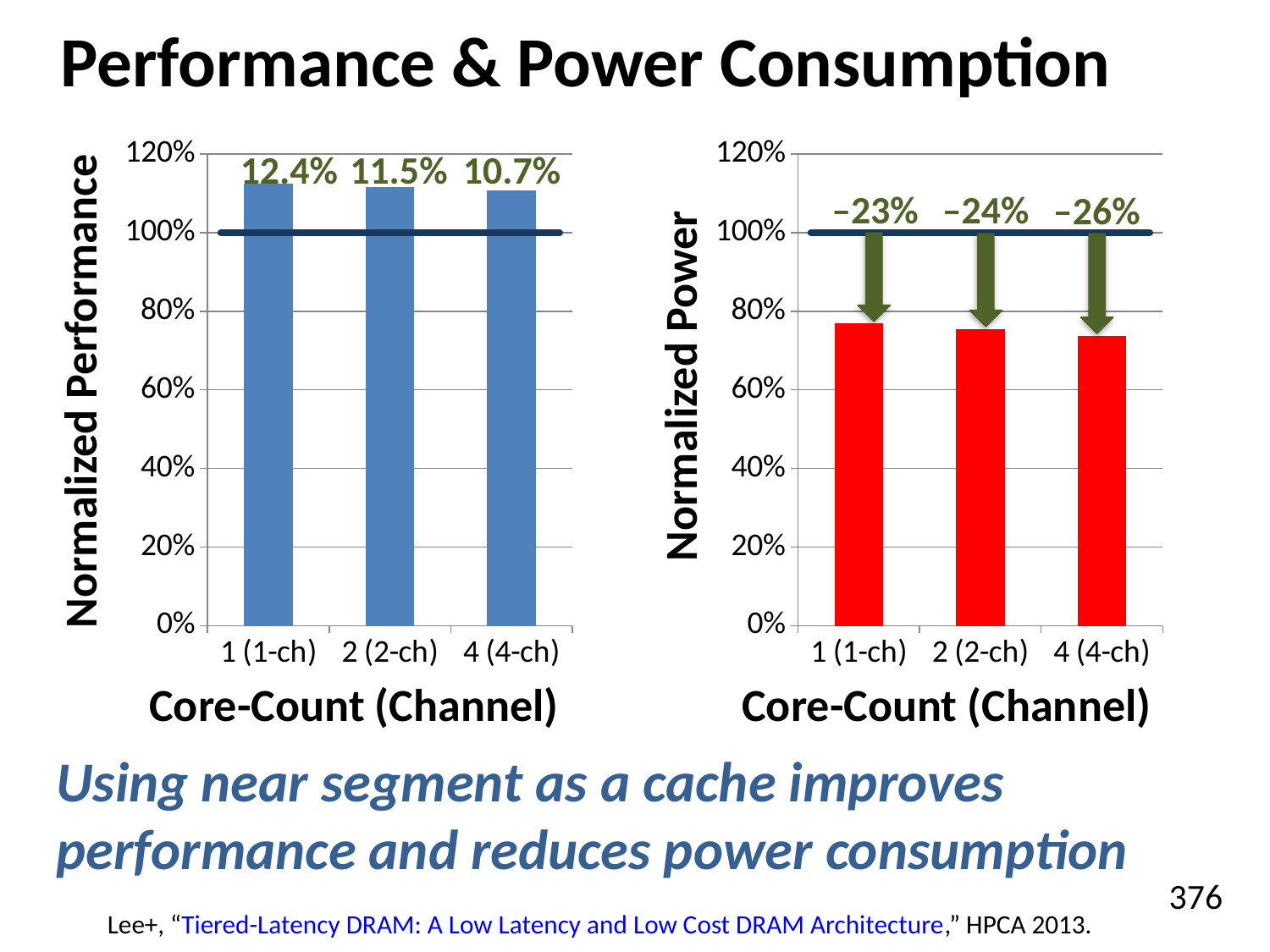
What is the x-axis title of the right chart (Normalized Power)? Core-Count (Channel) In the left chart (Normalized Performance), which core-count category has the highest normalized performance bar? 1 (1-ch) In the left chart (Normalized Performance), is the value for 2 (2-ch) greater or less than 100%? greater In the right chart (Normalized Power), which core-count category has the lowest normalized power bar? 4 (4-ch) What kind of chart is the left chart (Normalized Performance)? bar chart In the right chart (Normalized Power), what power reduction is printed above the bar for 2 (2-ch)? –24% In the right chart (Normalized Power), what power reduction is printed above the bar for 4 (4-ch)? –26% In the left chart (Normalized Performance), what performance improvement is printed above the bar for 1 (1-ch)? 12.4% In the right chart (Normalized Power), is the value for 1 (1-ch) greater or less than 80%? less How many categories are shown on the x axis of the right chart (Normalized Power)? 3 In the left chart (Normalized Performance), what performance improvement is printed above the bar for 4 (4-ch)? 10.7% In the left chart (Normalized Performance), do the bar values rise or fall as the core count increases along the x axis? fall